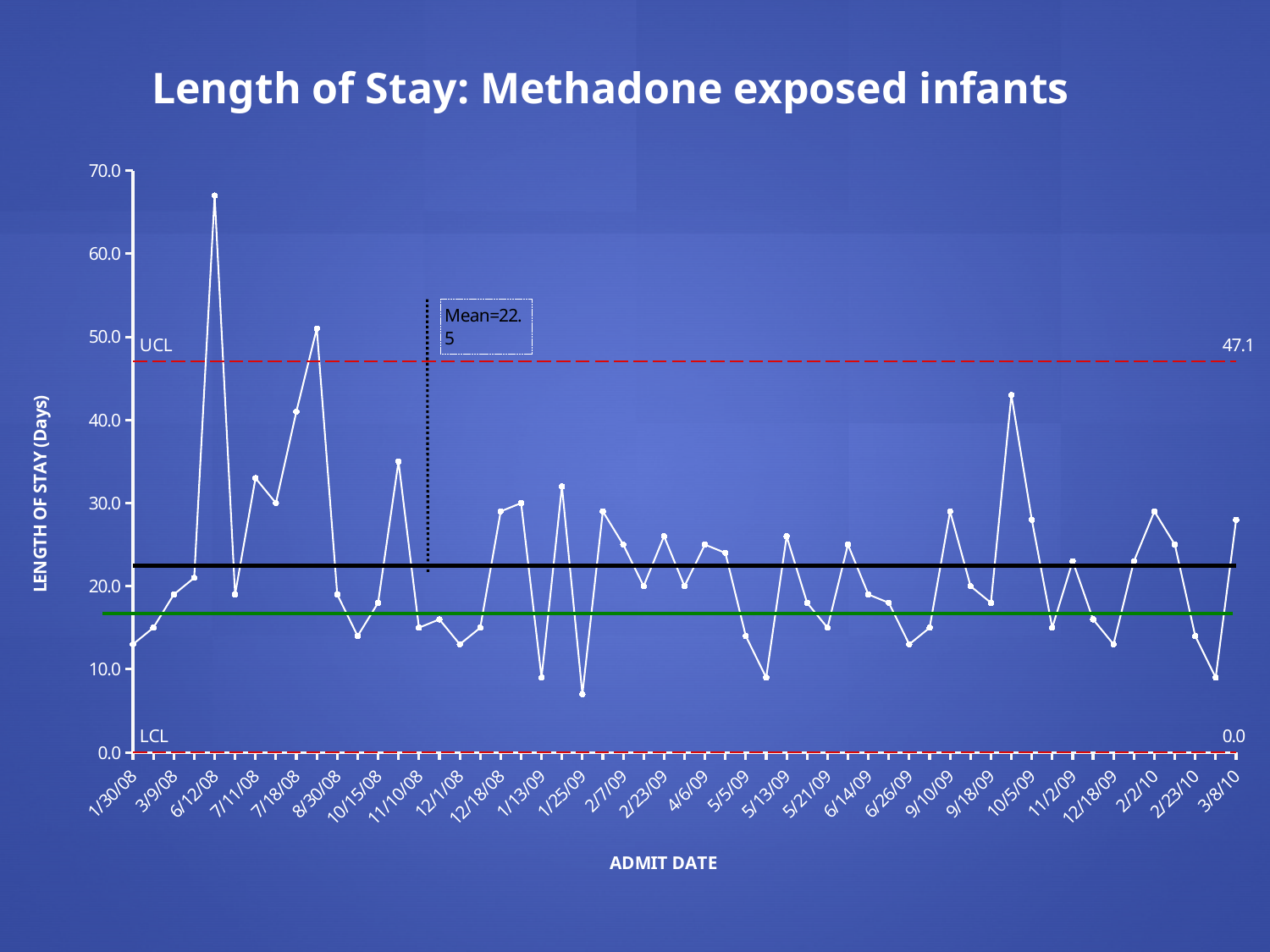
What is the title of the chart? Length of Stay: Methadone exposed infants What is the value of the UCL line shown on the chart? 47.1 What mean value is printed on the chart? 22.5 Is the length of stay for 1/25/09 greater or less than 10? less What is the label on the y axis of the chart? LENGTH OF STAY (Days) Which is larger, the length of stay for 1/30/08 or for 6/12/08? 6/12/08 Which admit date has the highest length of stay on the chart? 6/12/08 Is the length of stay for 6/12/08 greater or less than 60? greater What is the difference between the UCL value and the mean value printed on the chart? 24.6 What kind of chart is shown on the slide? line chart Is the length of stay for 1/30/08 greater or less than 20? less What is the value of the LCL line shown on the chart? 0.0